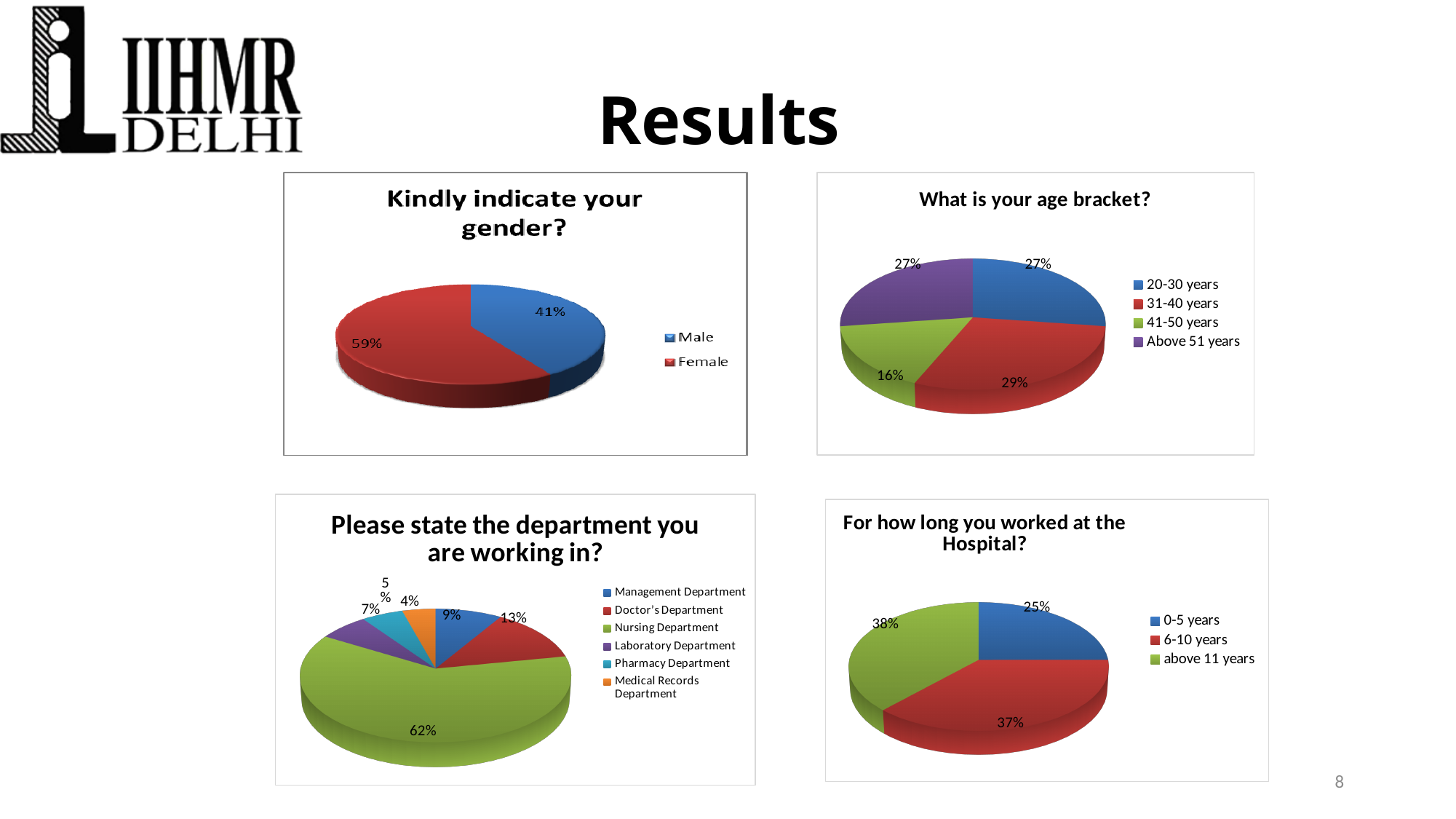
In the 'Please state the department you are working in?' chart, what share is the Nursing Department slice? 62% In the 'Please state the department you are working in?' chart, how many departments are shown? 6 In the 'For how long you worked at the Hospital?' chart, which is larger: the 6-10 years slice or the 0-5 years slice? 6-10 years In the 'What is your age bracket?' chart, which age bracket has the smallest share? 41-50 years In the 'What is your age bracket?' chart, how many age brackets does the legend list? 4 In the 'Please state the department you are working in?' chart, which department has the largest share? Nursing Department What type of chart is used for 'Kindly indicate your gender?' Pie chart In the 'Please state the department you are working in?' chart, what is the difference between the Doctor's Department and Management Department shares? 4% In the 'Kindly indicate your gender?' chart, what percentage of respondents are Male? 41% In the 'What is your age bracket?' chart, what share is the 41-50 years slice? 16% In the 'For how long you worked at the Hospital?' chart, what share of respondents worked 0-5 years? 25% In the 'Kindly indicate your gender?' chart, what percentage of respondents are Female? 59%